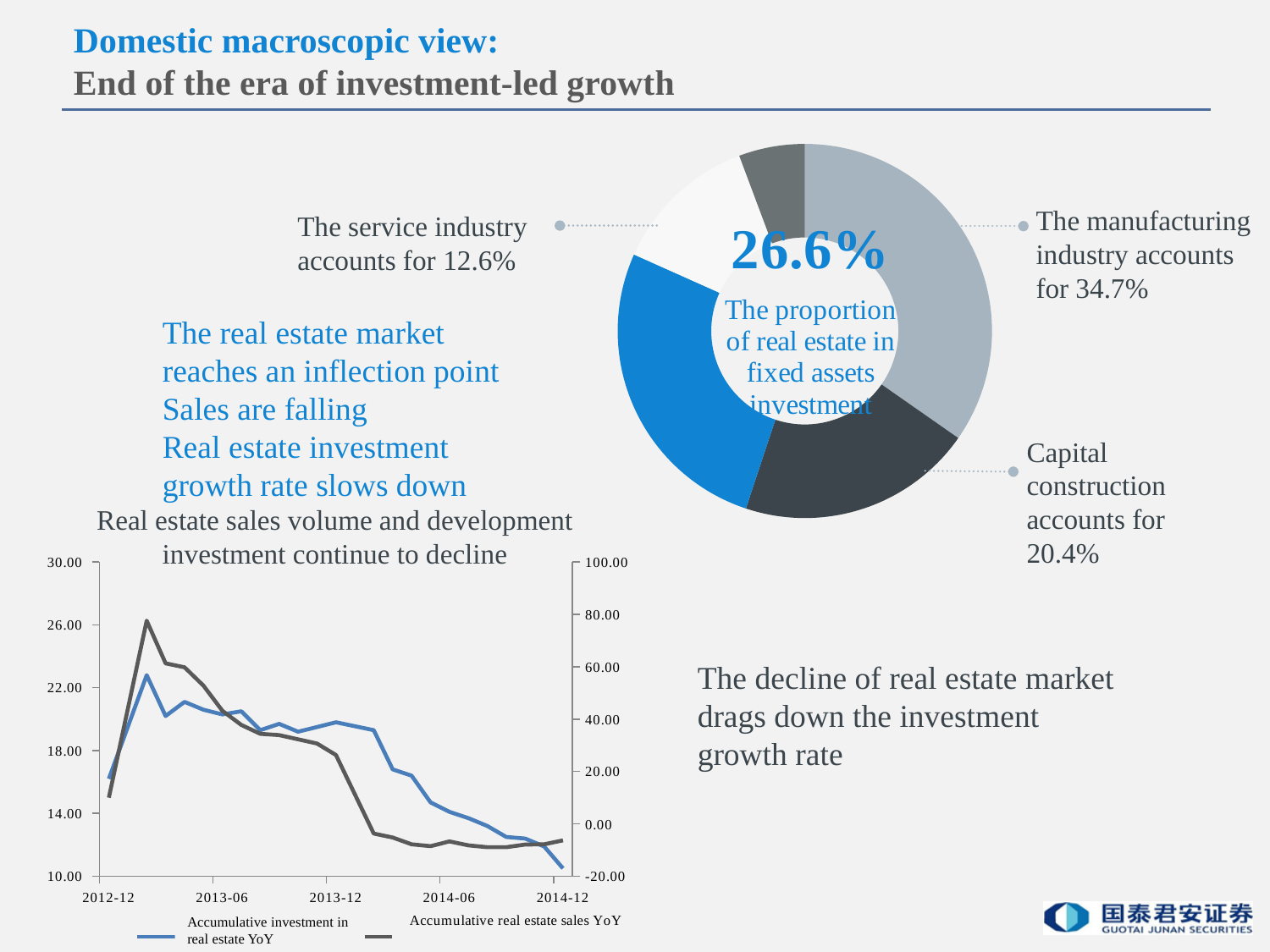
In the donut chart, which labelled sector accounts for the largest share of fixed assets investment? The manufacturing industry How many series does the legend of the line chart list? 2 In the donut chart, how many percentage points larger is the manufacturing industry's share than the real estate share? 8.1 In the donut chart, what share does capital construction account for? 20.4% In the donut chart, what is the proportion of real estate in fixed assets investment? 26.6% In the donut chart, which labelled sector accounts for the smallest share of fixed assets investment? The service industry In the line chart, does accumulative real estate sales YoY rise or fall between 2013-06 and 2014-12? Fall What kind of chart is the chart in the lower left of the slide? Line chart In the donut chart, which is larger: the share of capital construction or the share of the service industry? Capital construction In the line chart, is the value of accumulative investment in real estate YoY at 2014-12 greater or less than 14.00 on the left axis? less In the donut chart, what share does the service industry account for? 12.6% In the donut chart, what share does the manufacturing industry account for? 34.7%